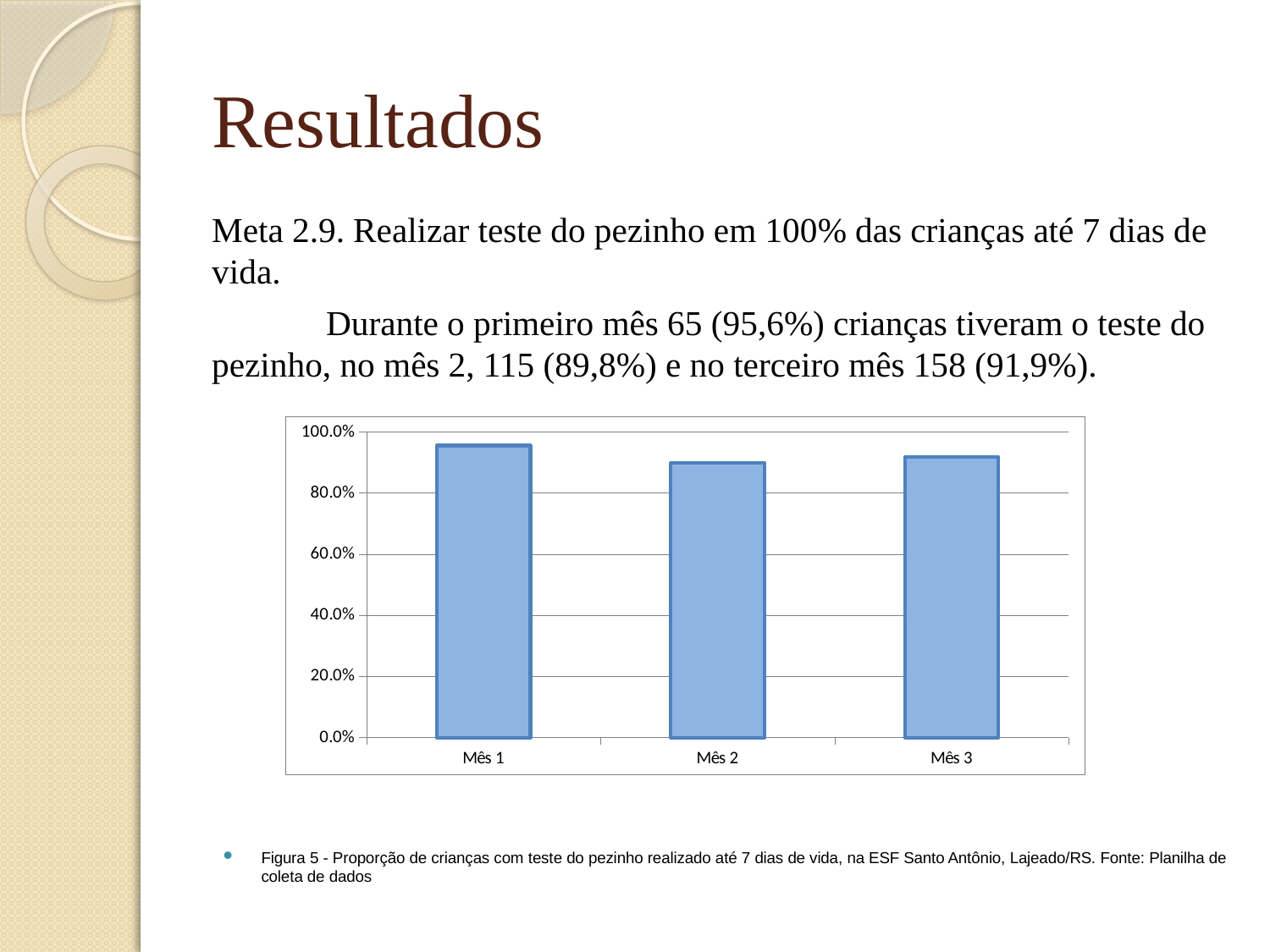
Does the value rise or fall from Mês 1 to Mês 2? fall How many categories are shown on the x axis of the chart? 3 Is the value for Mês 3 greater or less than 80.0%? greater What colour are the bars in the chart? blue Is the value for Mês 2 greater or less than 100.0%? less Which is larger, the value for Mês 1 or the value for Mês 2? Mês 1 Is the value for Mês 2 greater or less than 60.0%? greater What kind of chart is shown on the slide? bar chart Which category has the highest bar in the chart? Mês 1 What is the highest tick value shown on the y axis of the chart? 100.0%